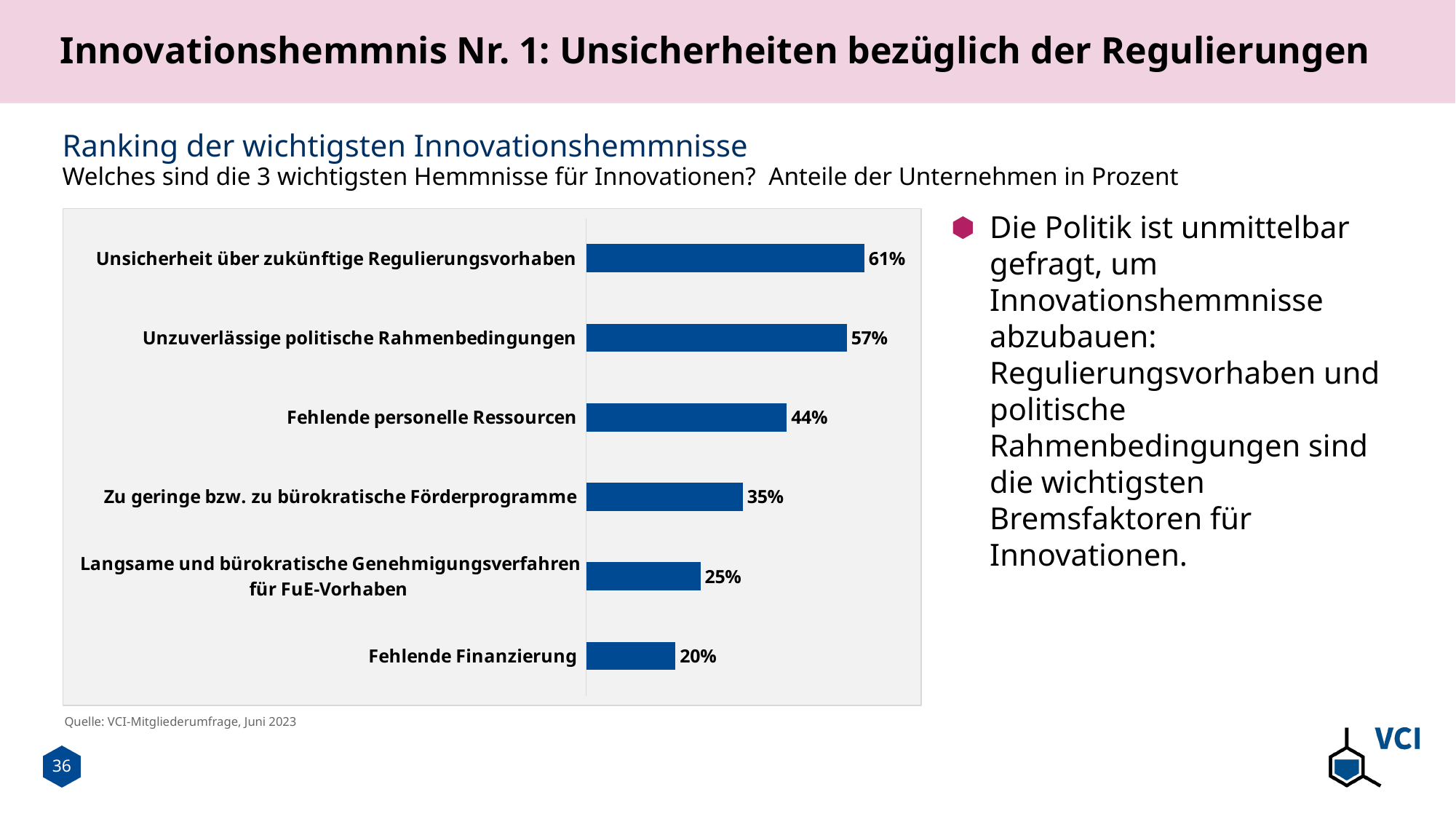
Which has a larger value: "Zu geringe bzw. zu bürokratische Förderprogramme" or "Fehlende Finanzierung"? Zu geringe bzw. zu bürokratische Förderprogramme Which category has the lowest value in the chart? Fehlende Finanzierung What source is cited for the chart data? VCI-Mitgliederumfrage, Juni 2023 What is the value shown for "Fehlende personelle Ressourcen"? 44% What is the difference between the values for "Fehlende personelle Ressourcen" and "Fehlende Finanzierung"? 24 percentage points What is the difference in percentage points between "Unsicherheit über zukünftige Regulierungsvorhaben" and "Unzuverlässige politische Rahmenbedingungen"? 4 percentage points What is the title of the chart on the slide? Ranking der wichtigsten Innovationshemmnisse What is the value shown for "Langsame und bürokratische Genehmigungsverfahren für FuE-Vorhaben"? 25% What percentage of companies named "Unsicherheit über zukünftige Regulierungsvorhaben" as an innovation obstacle? 61% Which category has the highest value in the chart? Unsicherheit über zukünftige Regulierungsvorhaben How many categories are shown in the chart? 6 What type of chart is shown on the slide? Bar chart